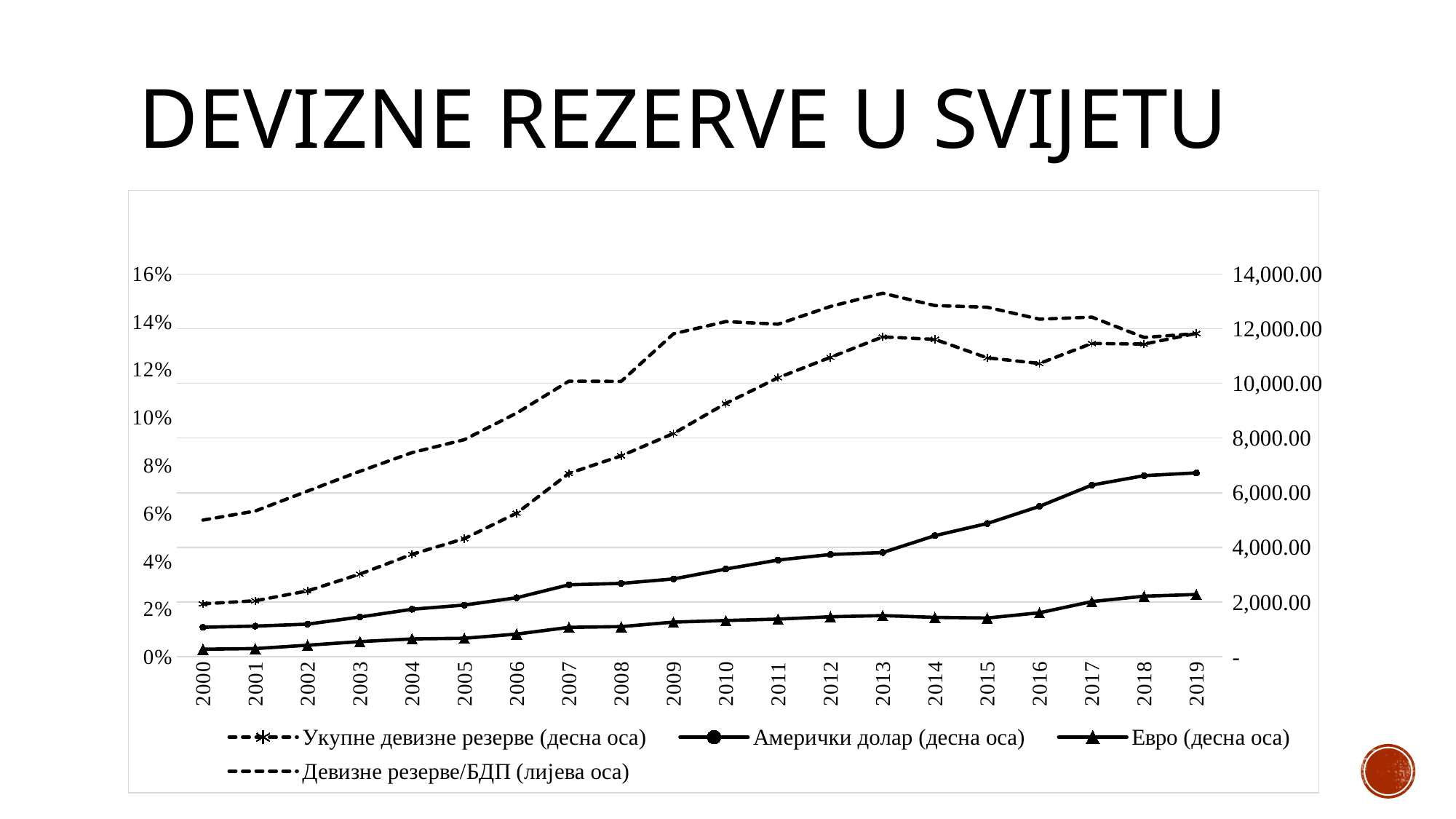
What kind of chart is shown on the slide? line chart In which year is the Евро series at its lowest? 2000 Is the value for Амерички долар in 2019 greater or less than 6,000.00? greater Is the value for Евро in 2019 greater or less than 4,000.00? less Which series is plotted against the left axis according to the legend? Девизне резерве/БДП (лијева оса) In 2019, which is larger: Амерички долар or Евро? Амерички долар Is the value for Укупне девизне резерве in 2010 greater or less than 8,000.00? greater What is the title of the slide containing the chart? DEVIZNE REZERVE U SVIJETU How many years are plotted along the x axis? 20 Does the Амерички долар series rise or fall from 2000 to 2019? rise How many series does the legend list? 4